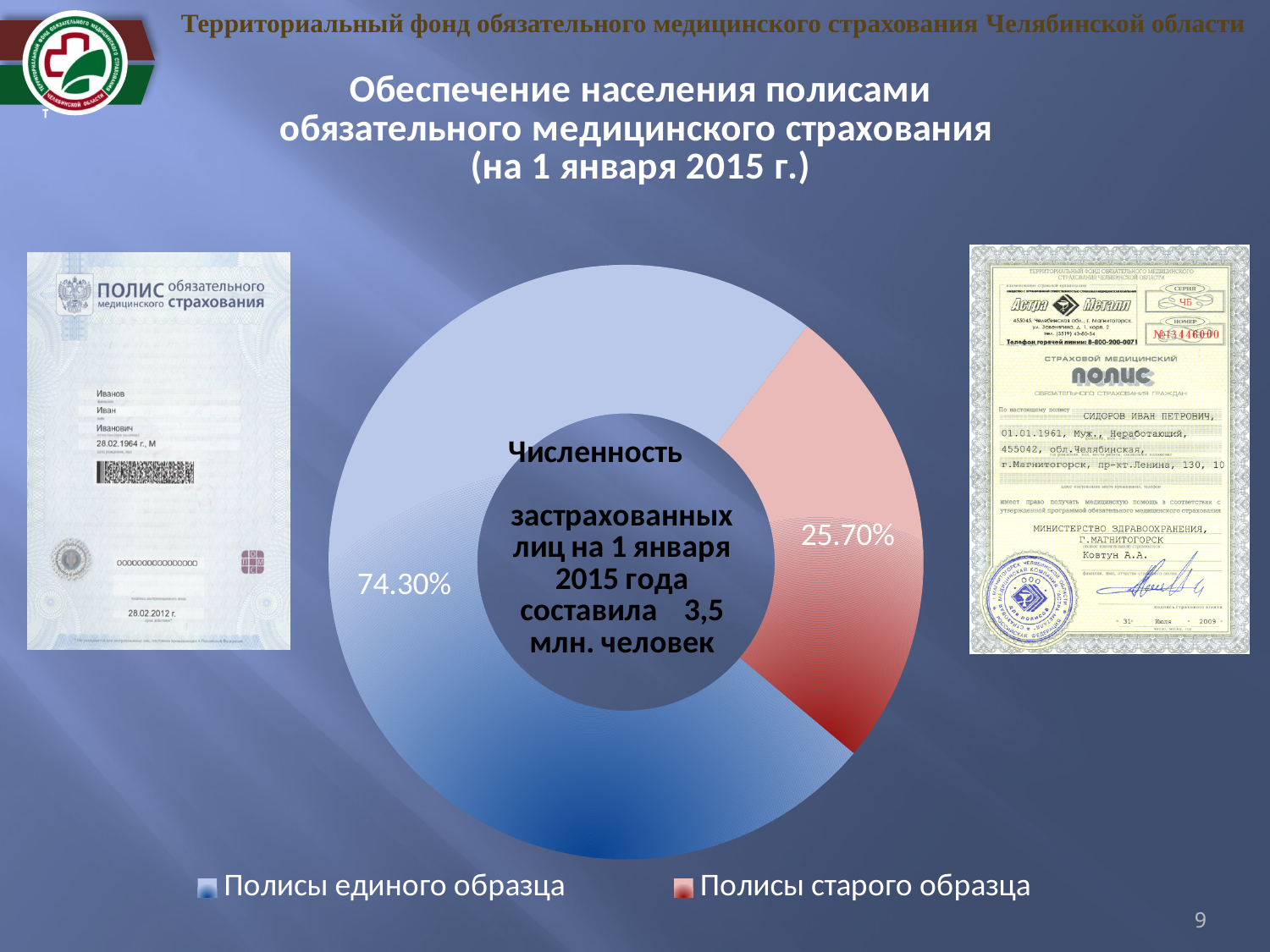
What kind of chart is shown on the slide? Doughnut (pie) chart What is the total of the two shares shown in the chart? 100% Which colour represents "Полисы старого образца" in the chart? Red Which category has the smallest share in the chart? Полисы старого образца According to the text in the centre of the chart, how many insured persons were there on 1 January 2015? 3,5 млн. человек How many entries does the chart legend list? 2 By how many percentage points does the share of "Полисы единого образца" exceed that of "Полисы старого образца"? 48.60% Which category has the largest share in the chart? Полисы единого образца Which is larger: the share of "Полисы единого образца" or "Полисы старого образца"? Полисы единого образца How many categories does the chart show? 2 What share of the doughnut chart is labelled "Полисы единого образца"? 74.30% What share of the doughnut chart is labelled "Полисы старого образца"? 25.70%